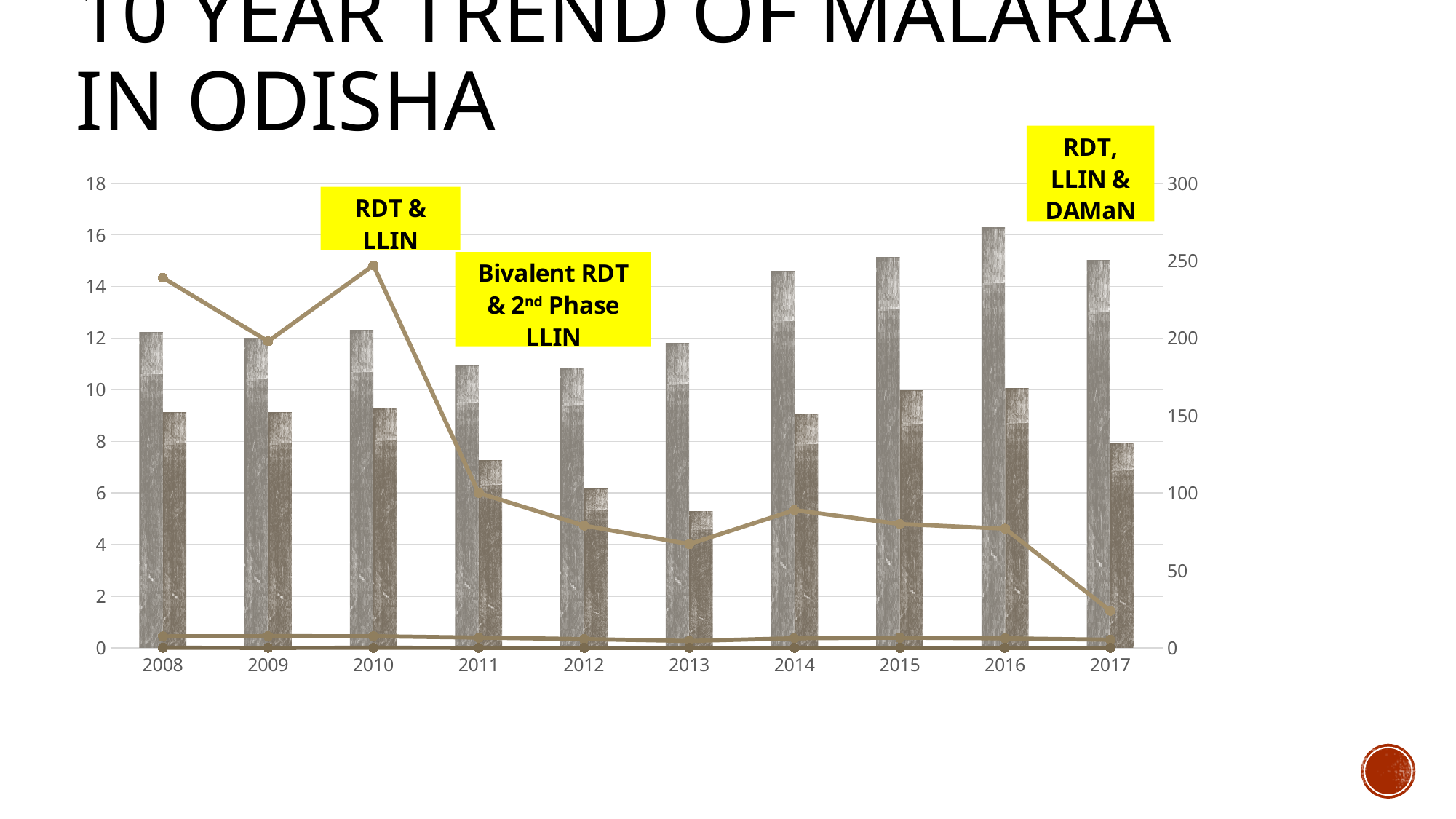
What is the first year shown on the x axis of the chart? 2008 In which year does the upper line reach its lowest point? 2017 What kind of chart is shown on the slide? A combined bar and line chart Is the tallest bar for 2016 greater or less than 14 on the left axis? greater In which year does the upper line reach its highest point? 2010 Which year has the shorter right-hand bar, 2013 or 2014? 2013 What is the highest value shown on the right-hand axis of the chart? 300 In which year is the tallest bar on the chart? 2016 Is the right-hand (shorter) bar for 2017 greater or less than 10 on the left axis? less Does the upper line rise or fall between 2014 and 2017? Fall Does the upper line rise or fall between 2010 and 2013? Fall How many years are shown along the x axis of the chart? 10